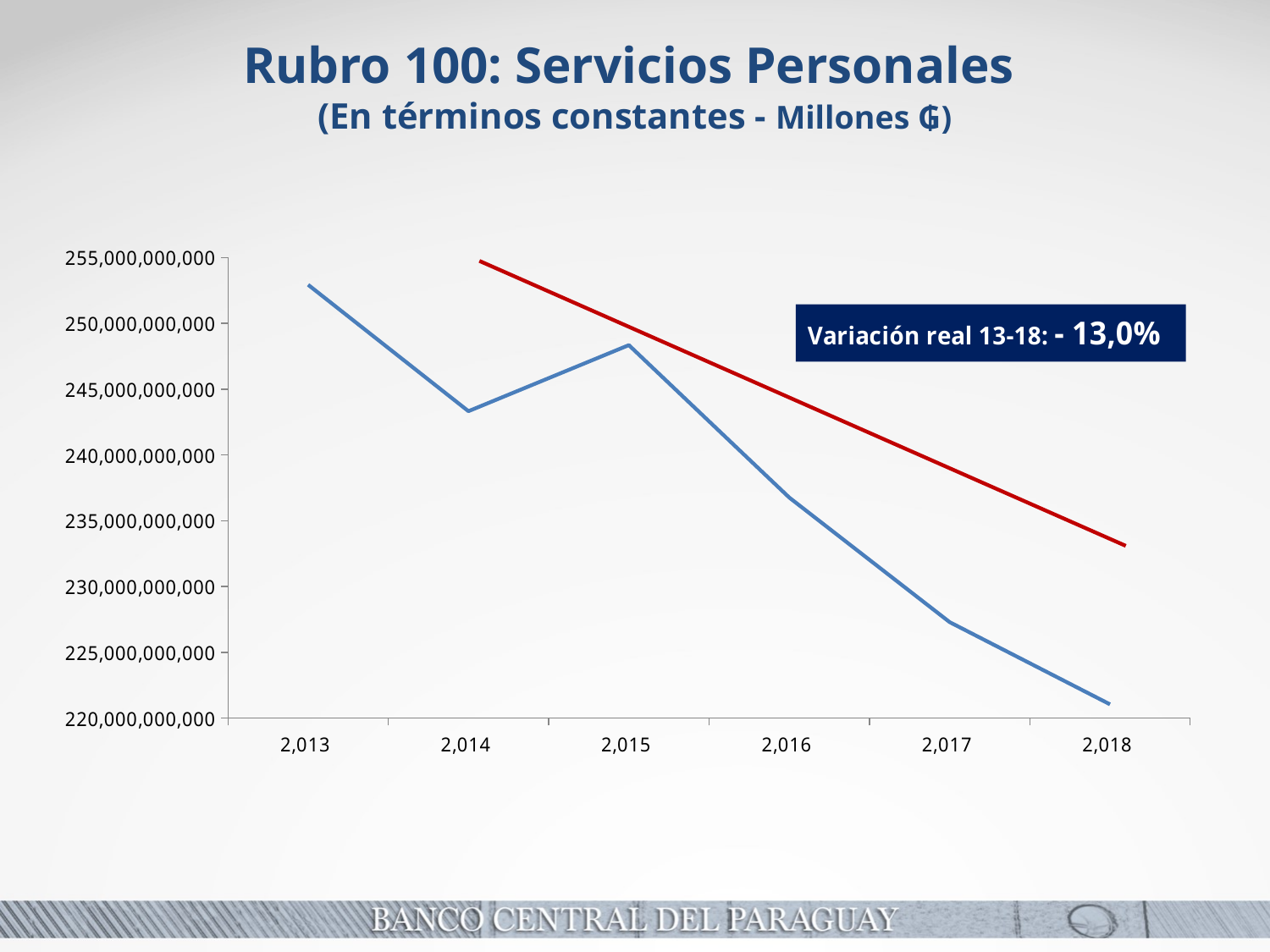
What is the title of the chart on the slide? Rubro 100: Servicios Personales How many years are plotted along the x axis of the chart? 6 Which year has the larger value, 2,014 or 2,015? 2,015 In which year is the value of the blue line highest? 2,013 In which year is the value of the blue line lowest? 2,018 Is the value for 2,017 greater or less than 230,000,000,000? less What real variation for 13-18 is stated in the box on the chart? - 13,0% Is the value for 2,014 greater or less than 245,000,000,000? less What kind of chart is shown on the slide? line chart Overall, does the blue line rise or fall from 2,013 to 2,018? fall Is the value for 2,018 greater or less than 225,000,000,000? less